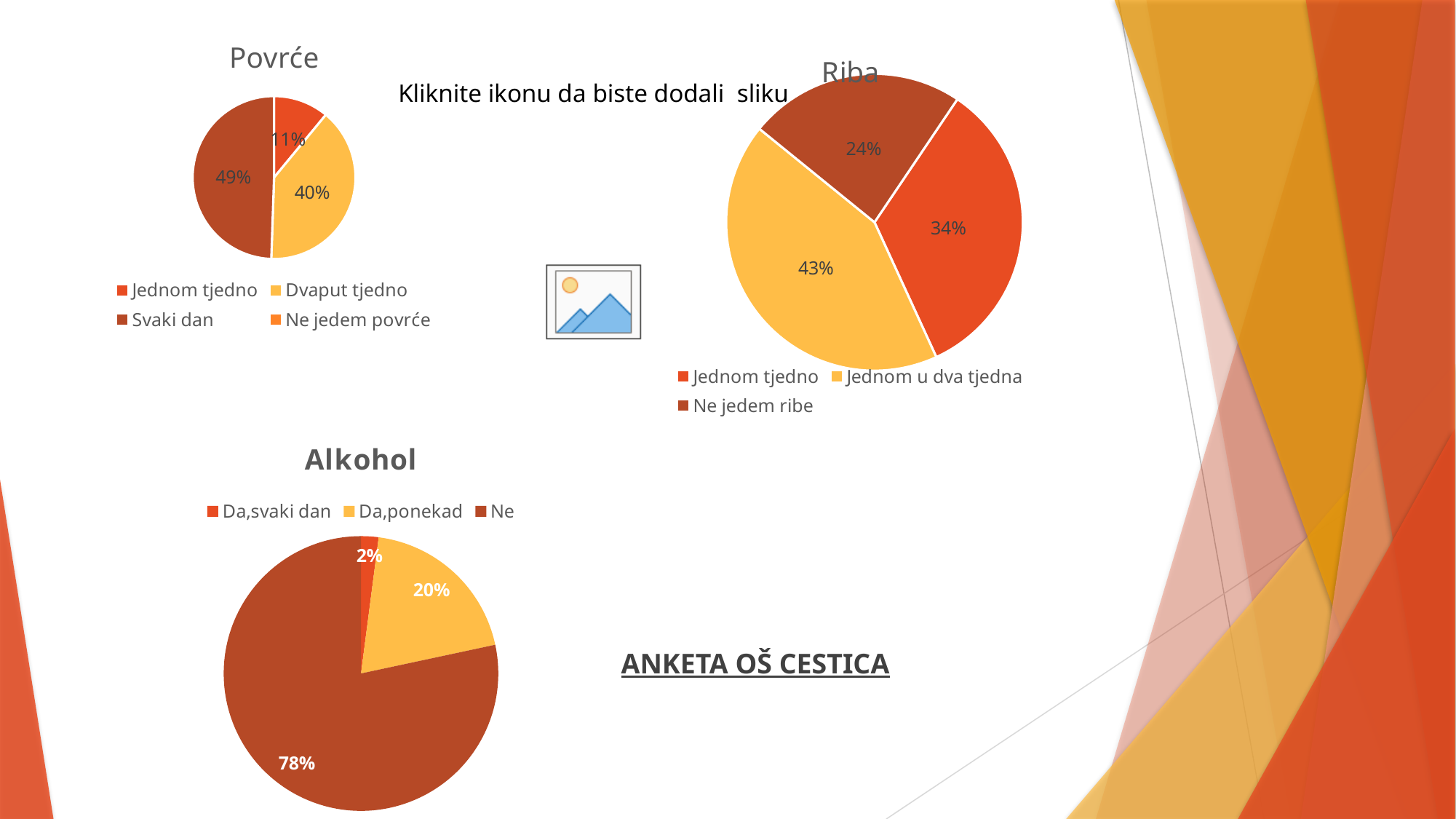
In the Riba chart, which category has the largest slice? Jednom u dva tjedna In the Povrće chart, what share is labelled for Dvaput tjedno? 40% In the Riba chart, what share is labelled for Ne jedem ribe? 24% In the Povrće chart, what share is labelled for Svaki dan? 49% In the Alkohol chart, which is larger: Da,ponekad or Da,svaki dan? Da,ponekad What type of chart is the Alkohol chart? Pie chart In the Povrće chart, which category has the smallest visible slice? Jednom tjedno In the Riba chart, what share is labelled for Jednom u dva tjedna? 43% In the Riba chart, what is the difference between the Jednom tjedno and Ne jedem ribe shares? 10% In the Povrće chart, how many entries does the legend list? 4 In the Alkohol chart, what share is labelled for Ne? 78% In the Alkohol chart, what share is labelled for Da,svaki dan? 2%